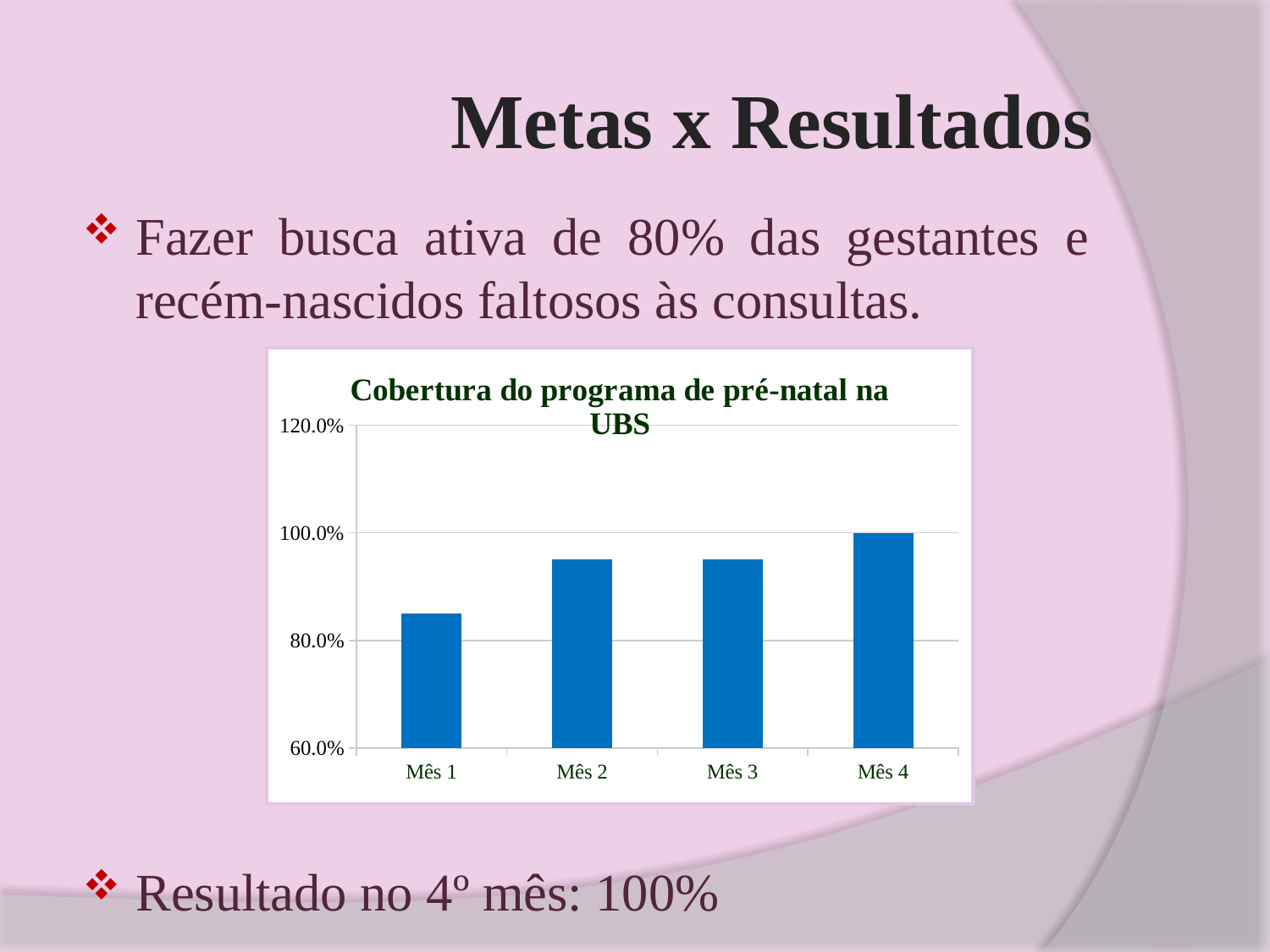
Which month has the lowest value in the chart? Mês 1 What kind of chart is shown on the slide? bar chart Which is larger, the value for Mês 1 or the value for Mês 4? Mês 4 What is the value for Mês 4? 100.0% Is the value for Mês 1 greater or less than 80.0%? greater Which is larger, the value for Mês 1 or the value for Mês 2? Mês 2 Do the values generally rise or fall from Mês 1 to Mês 4? rise Which month has the highest value in the chart? Mês 4 How many categories are shown on the x axis of the chart? 4 Is the value for Mês 2 greater or less than 100.0%? less What is the title of the chart? Cobertura do programa de pré-natal na UBS Is the value for Mês 3 greater or less than 80.0%? greater